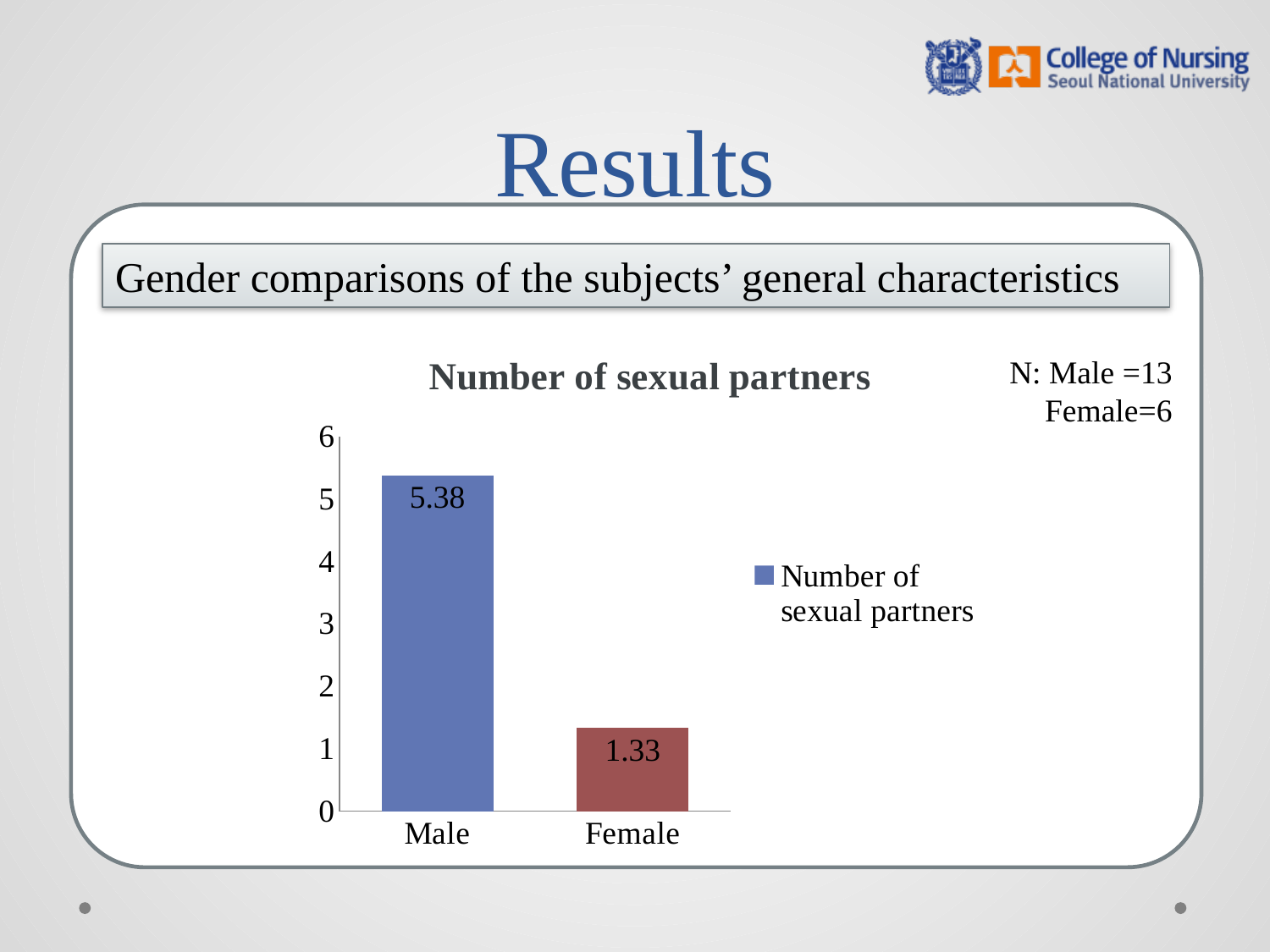
What is the value for Female in the chart? 1.33 Which is larger, the value for Male or the value for Female? Male Is the value for Female greater or less than 2? less What kind of chart is shown? bar chart What is the title of the chart? Number of sexual partners How many series does the legend list? 1 How many categories are shown on the x axis? 2 Which category has the highest value? Male What is the value for Male in the chart? 5.38 Which category has the lowest value? Female Is the value for Male greater or less than 4? greater What is the difference between the Male and Female values? 4.05